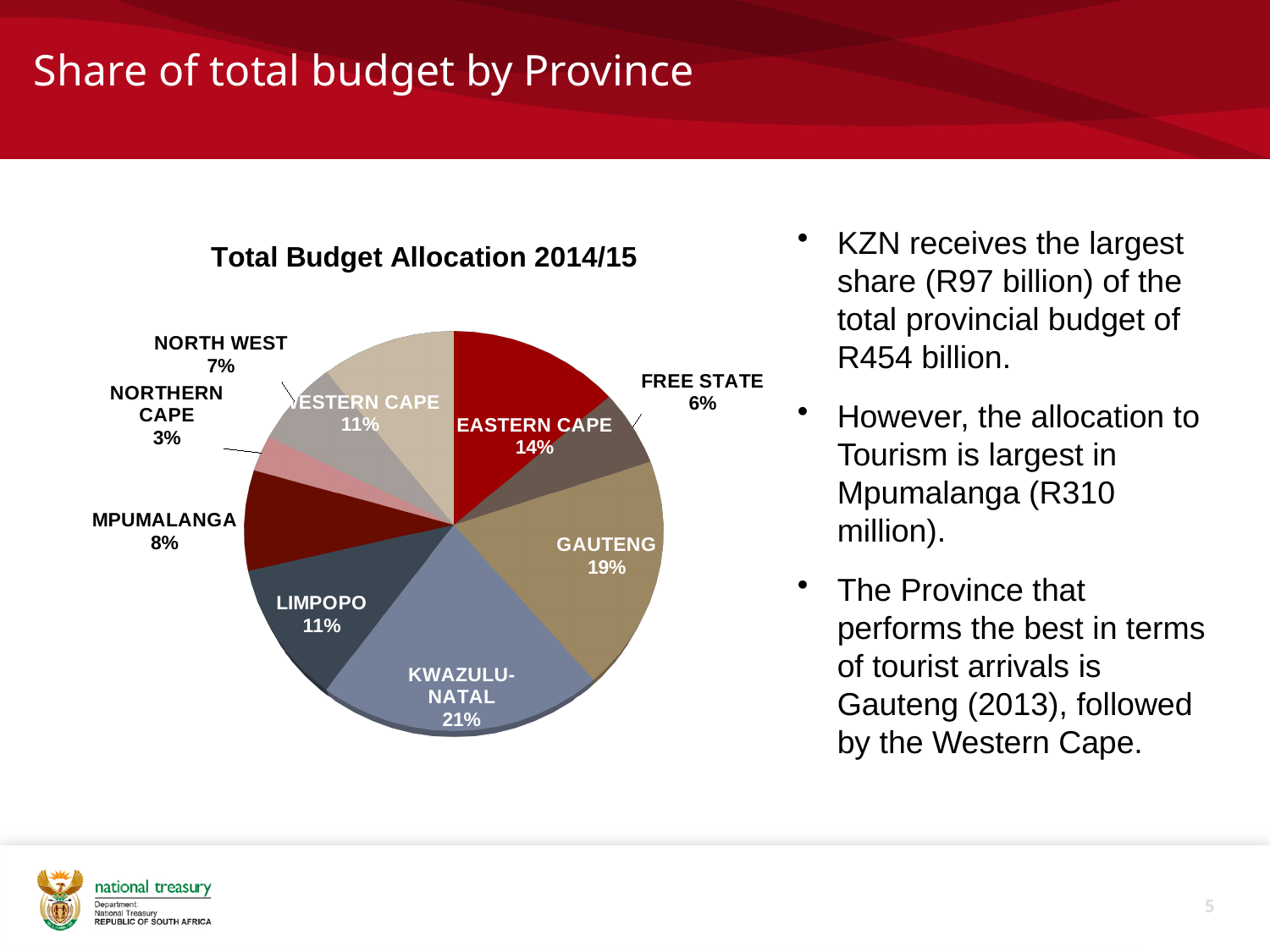
Which province has the largest share of the total budget allocation? Kwazulu-Natal What is the value shown for Mpumalanga? 8% Which province has the smallest share of the total budget allocation? Northern Cape Which has a larger share of the budget, Free State or North West? North West What share of the total budget allocation does Kwazulu-Natal receive? 21% What share of the total budget allocation does Gauteng receive? 19% What type of chart is shown on the slide? Pie chart What is the difference in percentage points between Gauteng's share and Eastern Cape's share? 5 What is the title of the chart? Total Budget Allocation 2014/15 How many provinces are shown in the pie chart? 9 What is the value shown for Northern Cape? 3% What is the combined share of Limpopo and Western Cape? 22%